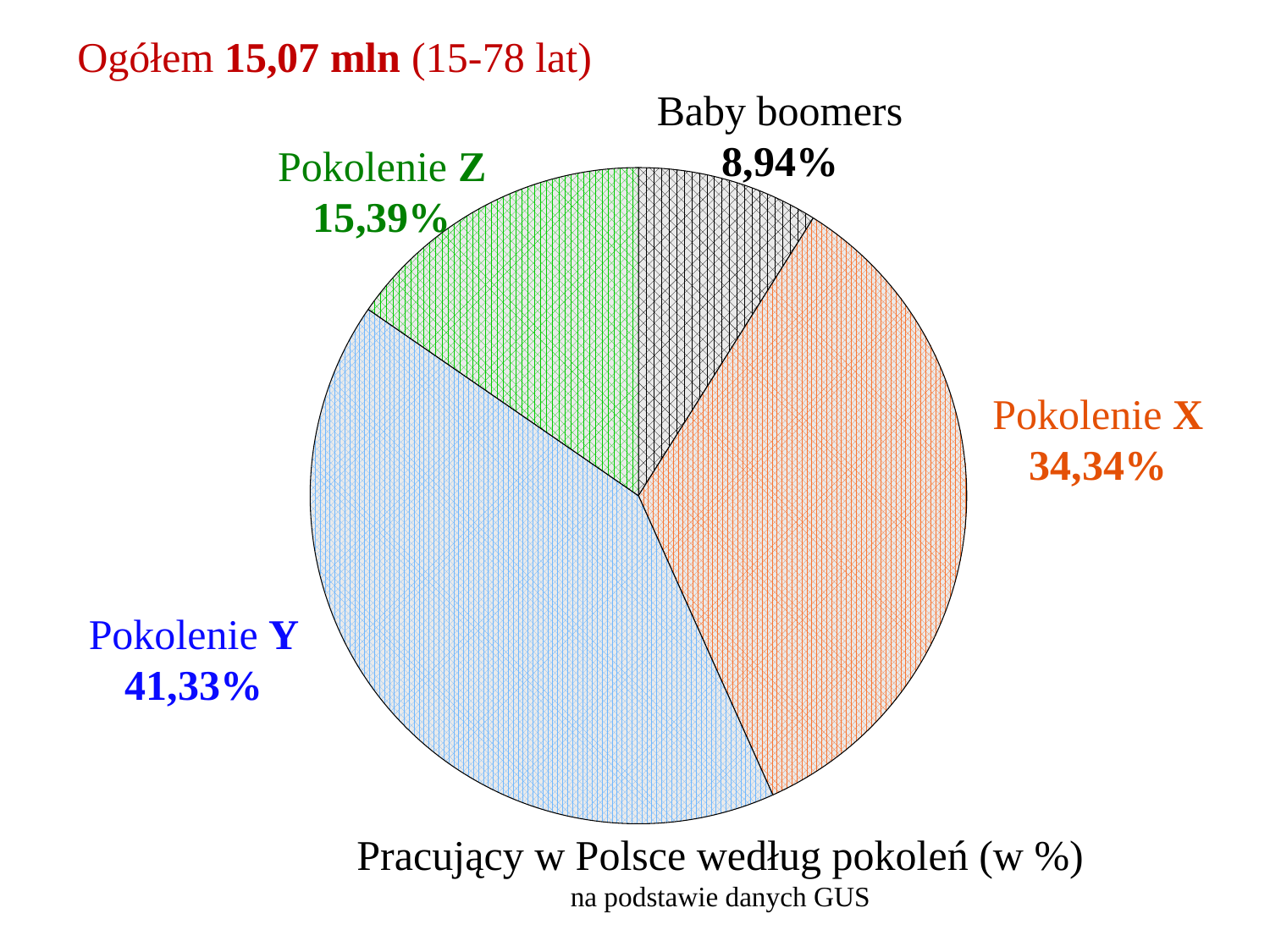
What share of the pie does Pokolenie Y have? 41,33% What is the difference in percentage points between Pokolenie Z and Baby boomers? 6,45 How many slices does the pie chart have? 4 What kind of chart is shown on the slide? Pie chart What is the difference in percentage points between Pokolenie Y and Pokolenie X? 6,99 What share of the pie do Baby boomers have? 8,94% Which has a larger share, Pokolenie Z or Baby boomers? Pokolenie Z What is the title of the chart? Pracujący w Polsce według pokoleń (w %) Which generation has the largest share of the pie? Pokolenie Y What share of the pie does Pokolenie X have? 34,34% Which generation has the smallest share of the pie? Baby boomers What share of the pie does Pokolenie Z have? 15,39%